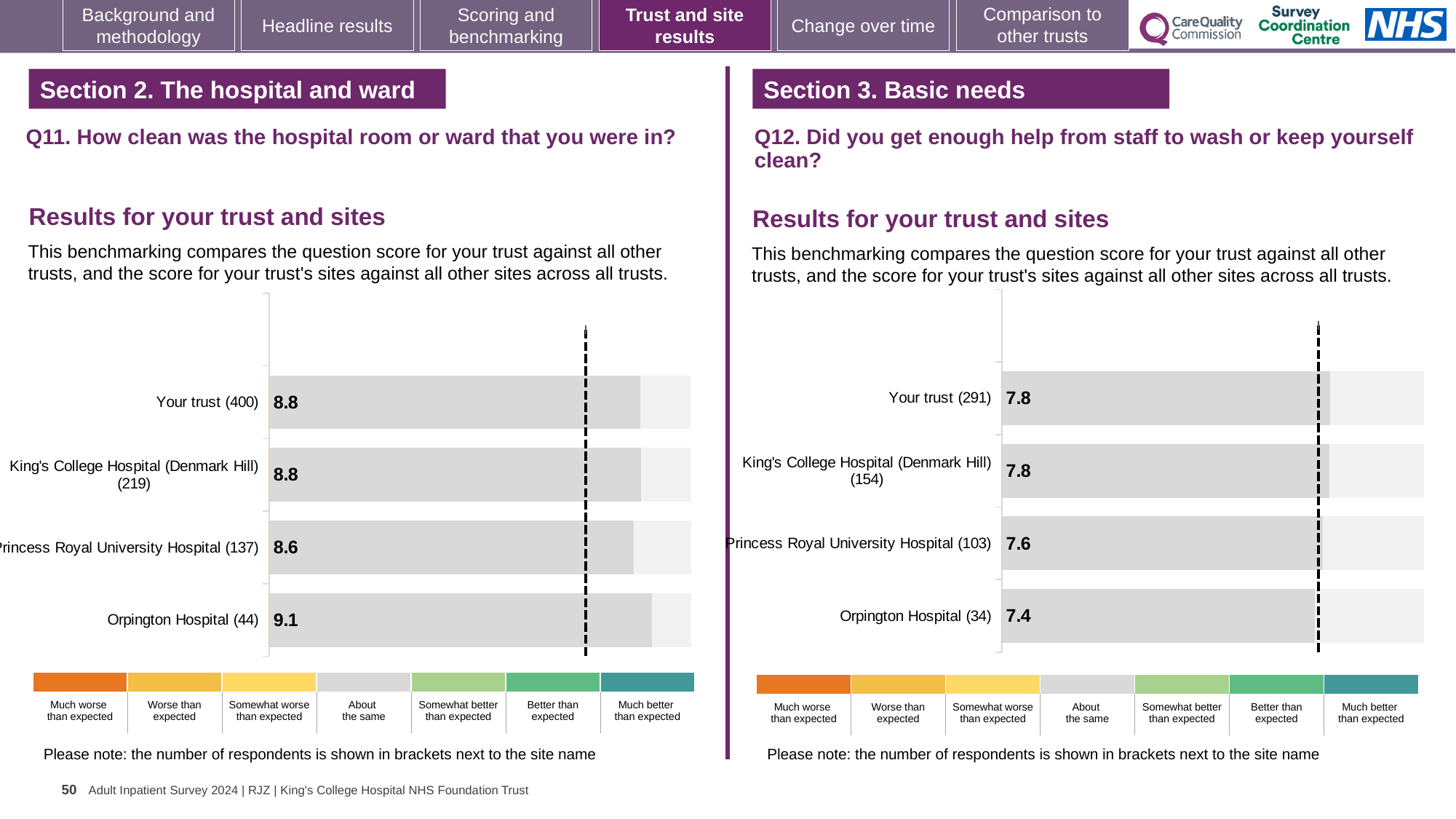
In the Q11 chart on the left, what is the score for Orpington Hospital? 9.1 In the Q12 chart on the right, what is the difference between the scores for King's College Hospital (Denmark Hill) and Orpington Hospital? 0.4 In the Q11 chart on the left, which site or trust has the highest score? Orpington Hospital In the Q11 chart on the left, what is the score for Princess Royal University Hospital? 8.6 How many bars are plotted in the Q11 chart on the left? 4 In the Q11 chart on the left, what is the difference between the scores for Orpington Hospital and Princess Royal University Hospital? 0.5 In the Q12 chart on the right, which has the larger score: Princess Royal University Hospital or Orpington Hospital? Princess Royal University Hospital In the Q11 chart on the left, which site or trust has the lowest score? Princess Royal University Hospital In the Q12 chart on the right, what is the score for Orpington Hospital? 7.4 What type of chart is used for the Q12 results on the right? Bar chart In the Q12 chart on the right, what is the score for Your trust? 7.8 In the Q12 chart on the right, which site or trust has the lowest score? Orpington Hospital